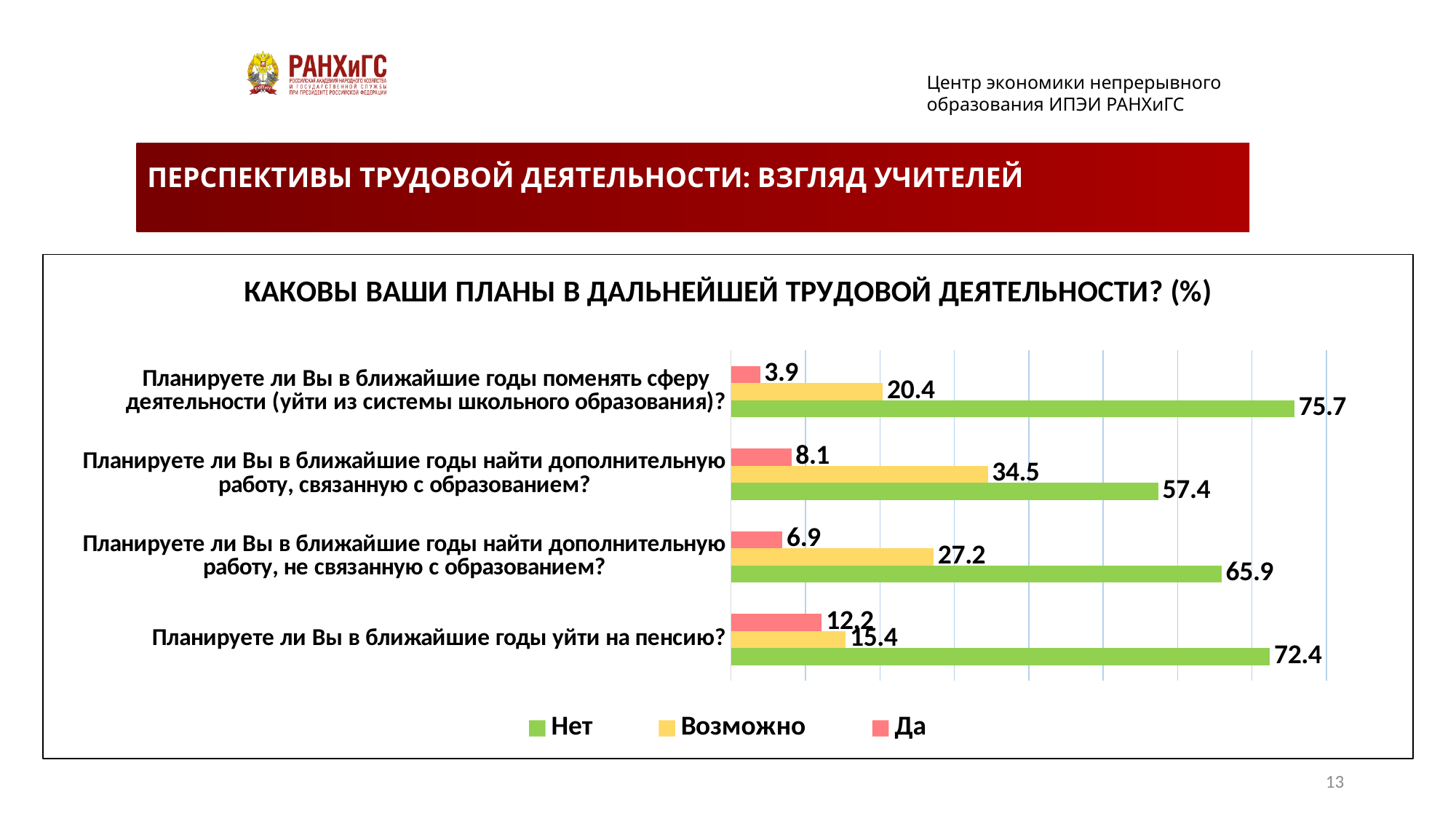
Which series is shown in green in the legend? Нет What is the value for "Нет" for the question about leaving the school education system (поменять сферу деятельности)? 75.7 Which question has the lowest "Да" value? Планируете ли Вы в ближайшие годы поменять сферу деятельности (уйти из системы школьного образования)? What is the value for "Да" for the question about retiring (уйти на пенсию)? 12.2 What type of chart is shown on the slide? Bar chart How many series does the legend list? 3 What is the difference between the "Нет" values for the question about leaving the school education system (75.7) and the question about additional work related to education (57.4)? 18.3 How many questions (categories) are shown in the chart? 4 Which question has the highest "Нет" value? Планируете ли Вы в ближайшие годы поменять сферу деятельности (уйти из системы школьного образования)? What is the total of the three values for the question about retiring (уйти на пенсию)? 100 What is the value for "Возможно" for the question about finding additional work related to education? 34.5 Which is larger: the "Возможно" value for additional work not related to education or the "Возможно" value for retiring? Additional work not related to education (27.2)